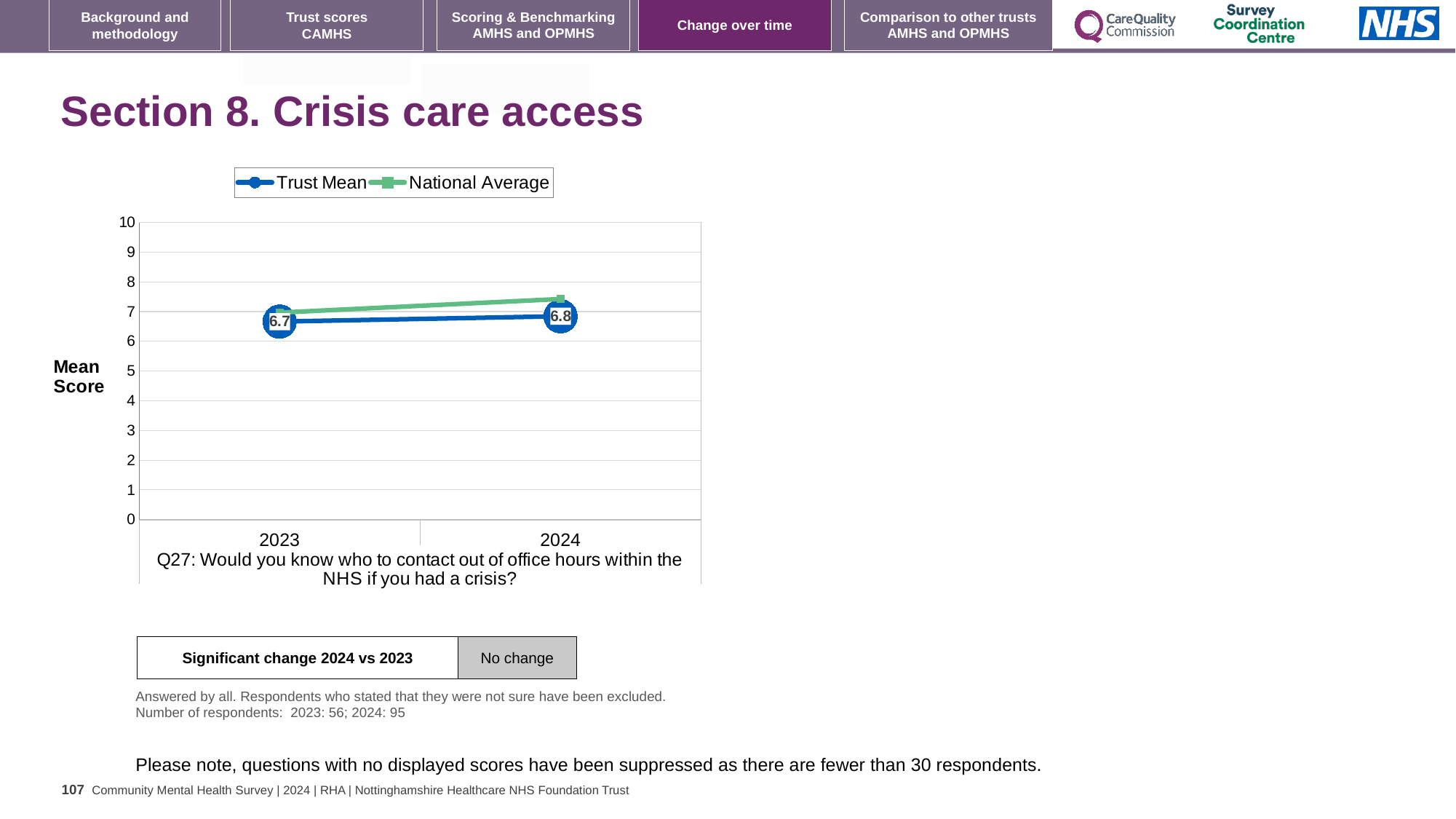
What is the Trust Mean value for 2024? 6.8 Does the National Average rise or fall from 2023 to 2024? rise What is the Trust Mean value for 2023? 6.7 How many years are plotted on the x axis? 2 Does the Trust Mean rise or fall from 2023 to 2024? rise What is the label on the y axis of the chart? Mean Score In 2024, which is higher, the Trust Mean or the National Average? National Average Is the National Average value for 2024 greater or less than 7? greater What kind of chart is shown? line chart How many series does the legend list? 2 Which year has the higher Trust Mean, 2023 or 2024? 2024 What is the difference between the Trust Mean in 2024 and in 2023? 0.1